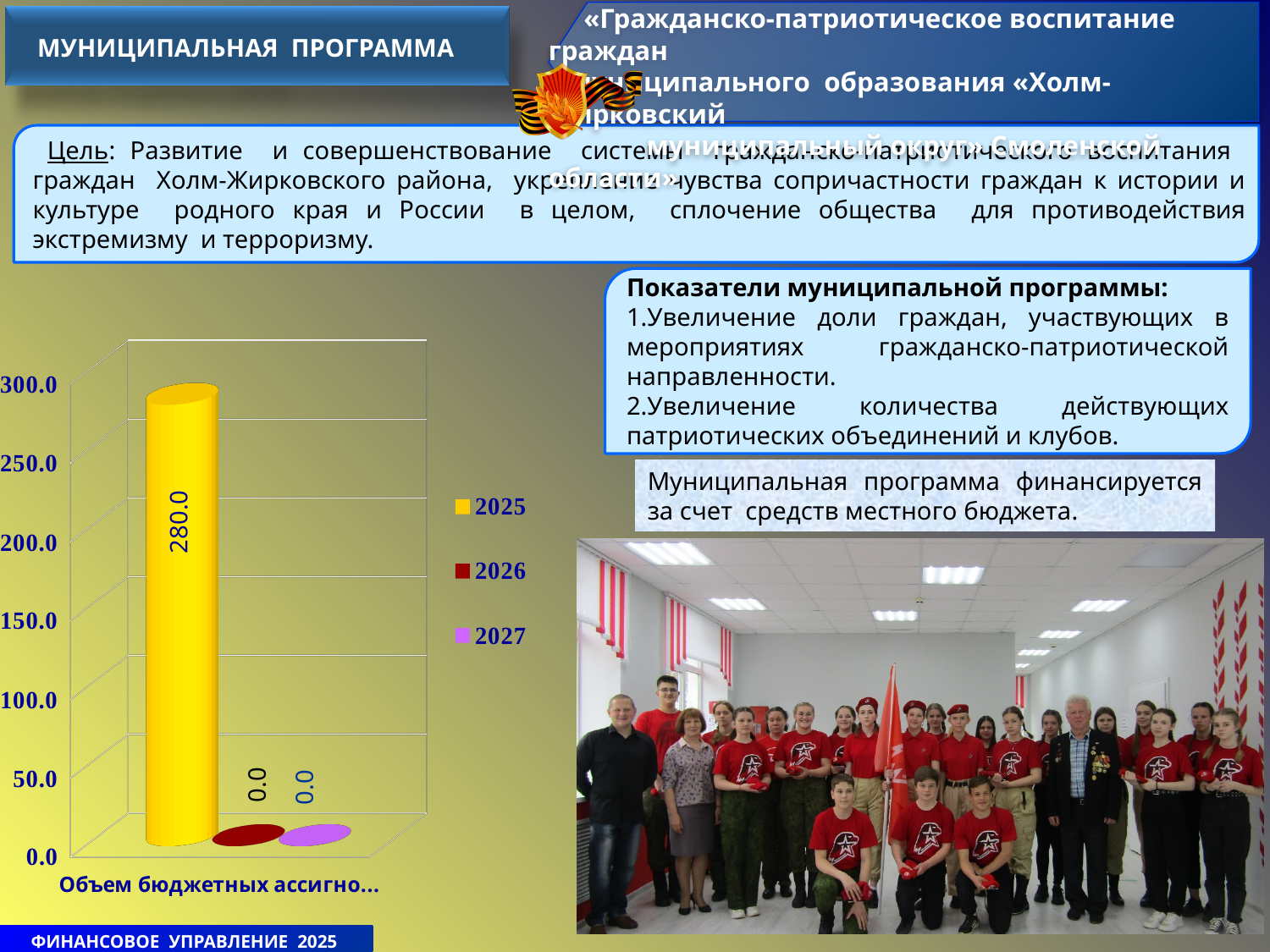
How many series does the chart legend list? 3 Which series has the highest value in the chart? 2025 Which is larger, the value for 2025 or the value for 2027? 2025 What is the value for the 2025 series in the chart? 280.0 What colour represents the 2025 series in the chart legend? yellow What is the highest value shown on the vertical axis of the chart? 300.0 What kind of chart is shown on the slide? bar chart What is the value for the 2026 series in the chart? 0.0 Is the value for 2025 greater or less than 250.0? greater What is the difference between the 2025 value and the 2026 value? 280.0 What is the value for the 2027 series in the chart? 0.0